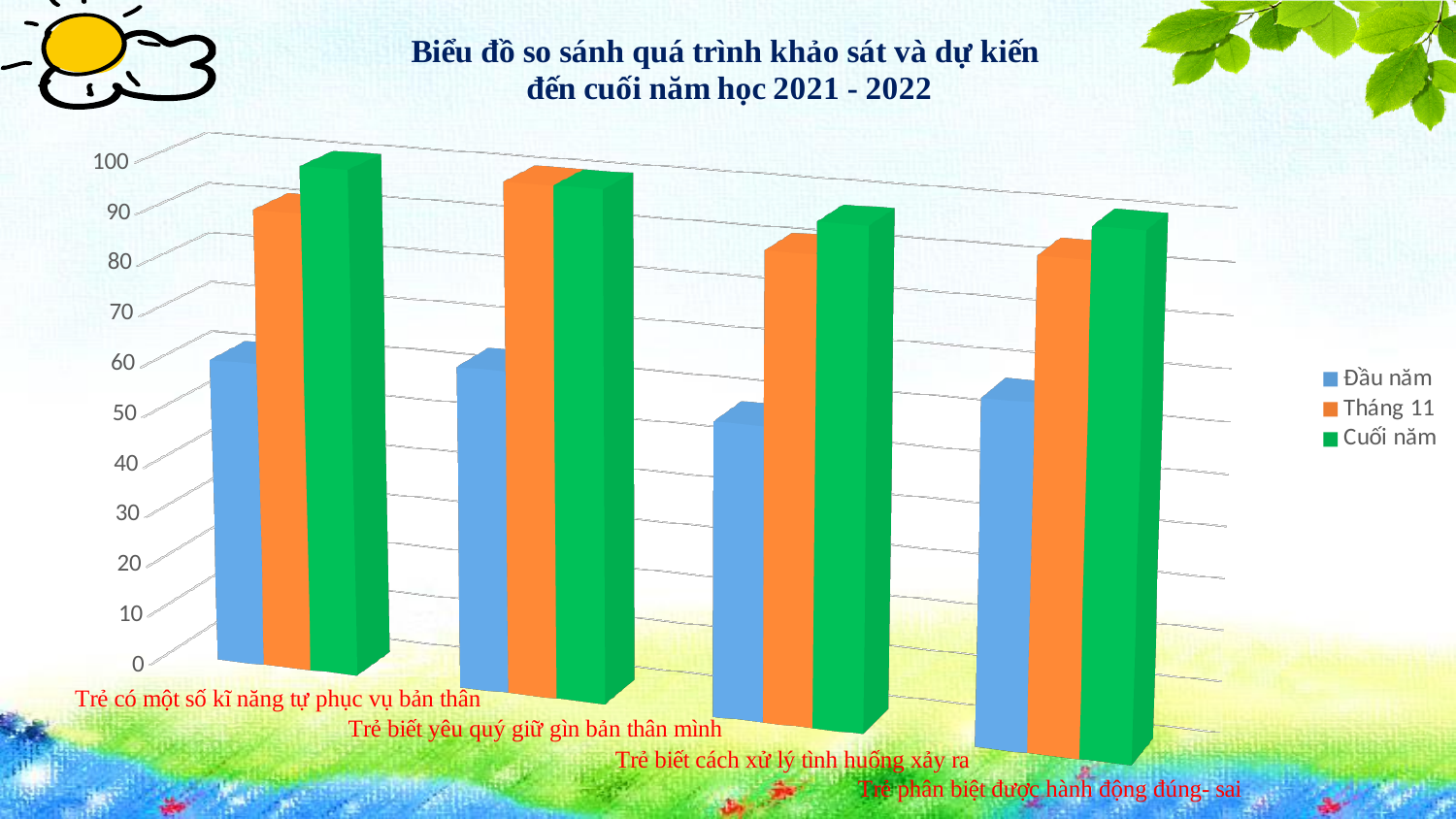
Is the Tháng 11 value for 'Trẻ biết cách xử lý tình huống xảy ra' greater or less than 40? greater Within each category, which series has the lowest bar? Đầu năm What kind of chart is shown on the slide? Bar chart How many series does the legend list? 3 For 'Trẻ biết cách xử lý tình huống xảy ra', which is larger: the Đầu năm value or the Tháng 11 value? Tháng 11 For 'Trẻ có một số kĩ năng tự phục vụ bản thân', which is larger: the Đầu năm value or the Cuối năm value? Cuối năm Is the Đầu năm value for 'Trẻ có một số kĩ năng tự phục vụ bản thân' greater or less than 80? less Is the Đầu năm value for 'Trẻ phân biệt được hành động đúng- sai' greater or less than 70? less What are the three series named in the legend? Đầu năm, Tháng 11, Cuối năm How many categories are shown on the x axis of the chart? 4 What is the title of the chart? Biểu đồ so sánh quá trình khảo sát và dự kiến đến cuối năm học 2021 - 2022